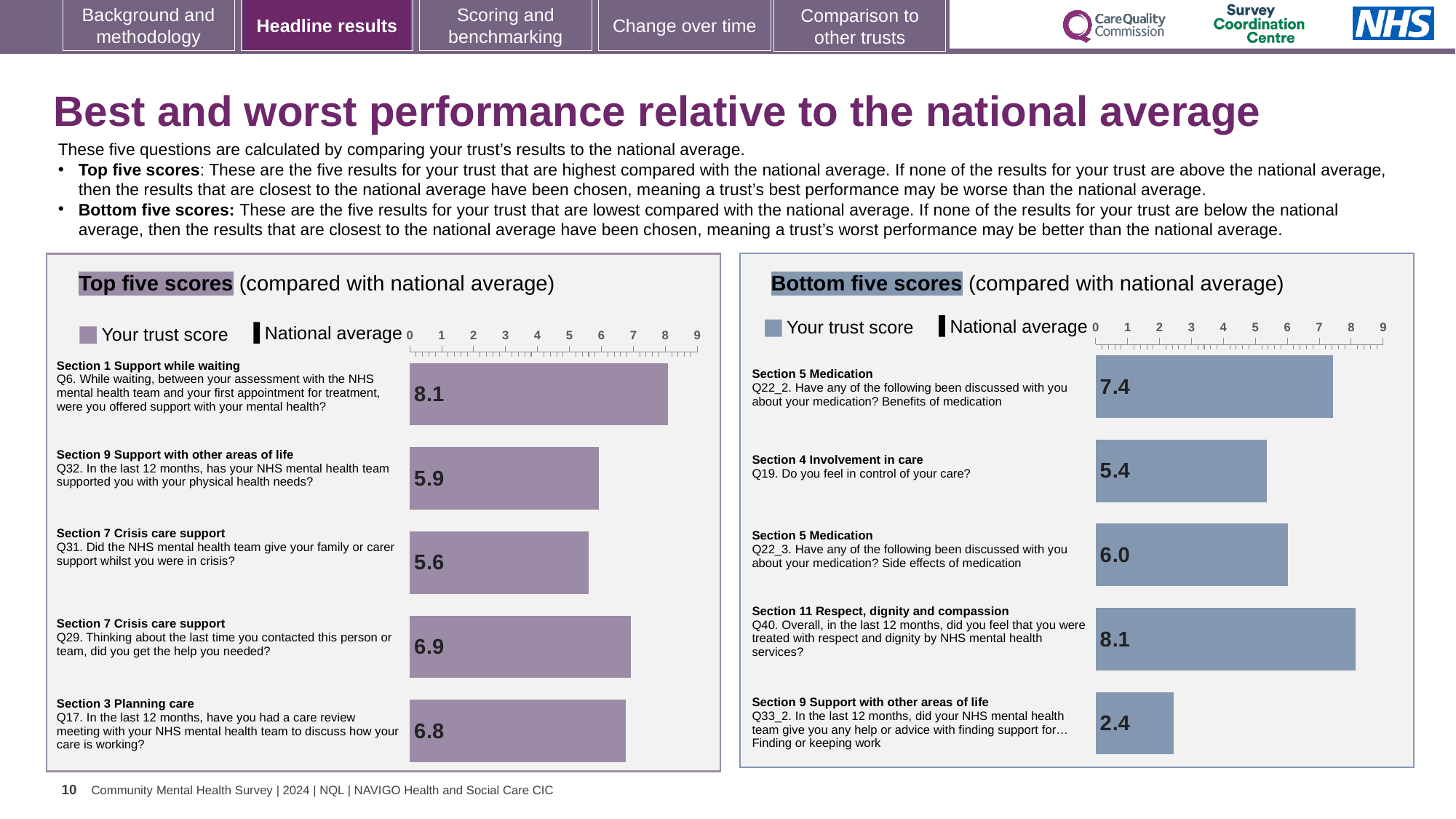
What type of chart is the Top five scores chart? Bar chart In the Top five scores chart, what is the trust score for Q6 (support while waiting)? 8.1 How many bars are shown in the Bottom five scores chart? 5 In the Bottom five scores chart, what is the trust score for Q33_2 (finding or keeping work)? 2.4 In the Bottom five scores chart, what is the difference between the scores for Q40 and Q33_2? 5.7 In the Top five scores chart, what is the trust score for Q31 (family or carer support in crisis)? 5.6 In the Bottom five scores chart, which question has the lowest trust score? Q33_2 (Section 9 Support with other areas of life) How many series does the legend of the Bottom five scores chart list? 2 In the Top five scores chart, which question has the highest trust score? Q6 (Section 1 Support while waiting) In the Top five scores chart, which has the larger score, Q32 or Q29? Q29 In the Bottom five scores chart, what is the trust score for Q19 (feeling in control of your care)? 5.4 In the Top five scores chart, what is the difference between the scores for Q29 and Q17? 0.1